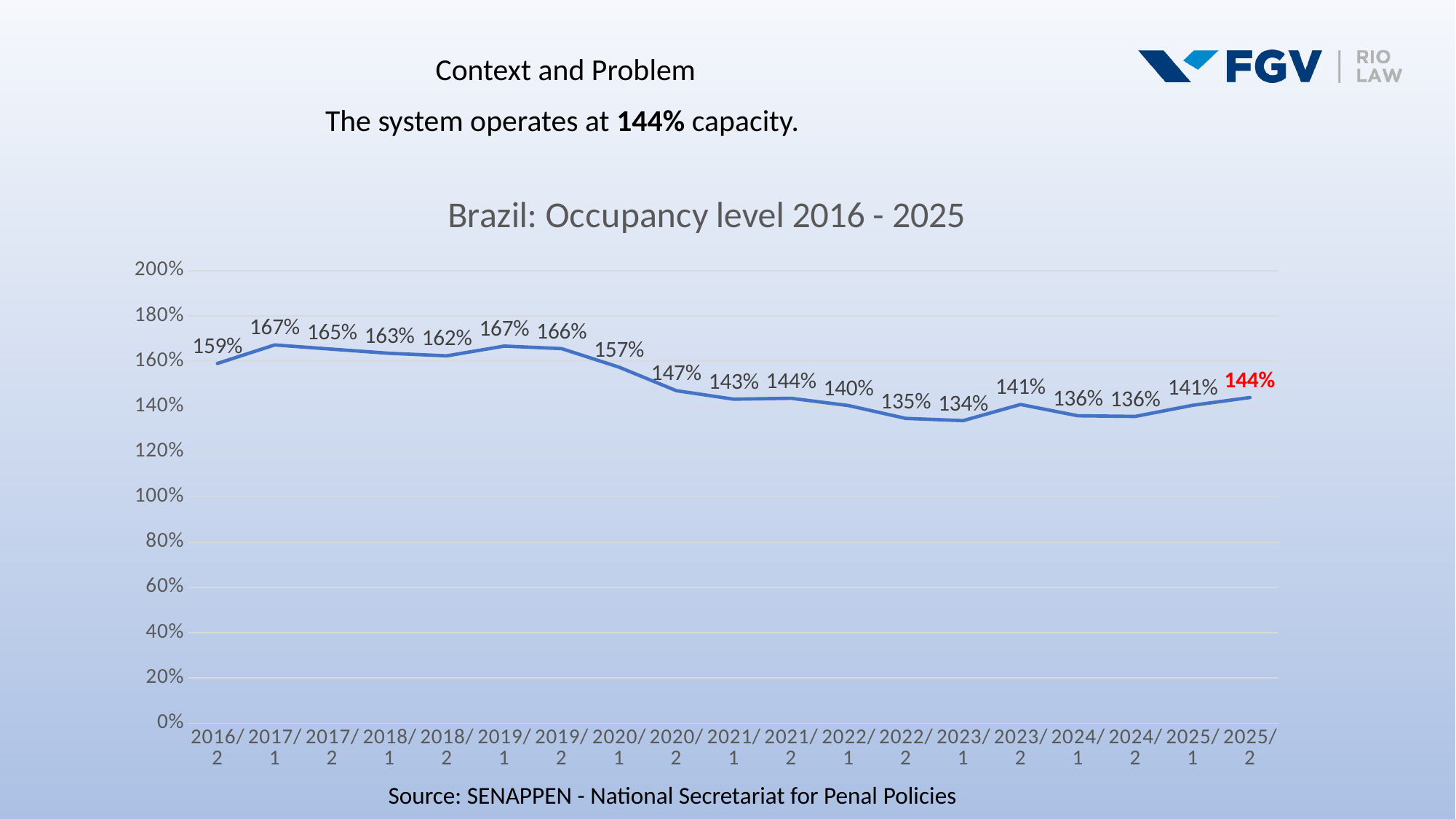
What is the occupancy level for 2023/2? 141% What is the highest occupancy level shown on the chart? 167% Which is larger, the occupancy level in 2019/2 or in 2022/1? 2019/2 What is the difference between the occupancy level in 2017/1 and in 2025/2? 23% What kind of chart is shown on the slide? Line chart Does the occupancy level generally rise or fall from 2016/2 to 2025/2? Fall What is the occupancy level for 2016/2? 159% What is the occupancy level for 2020/1? 157% What is the title of the chart? Brazil: Occupancy level 2016 - 2025 How many periods are plotted on the chart? 19 Which period has the lowest occupancy level? 2023/1 What is the occupancy level for 2025/2? 144%